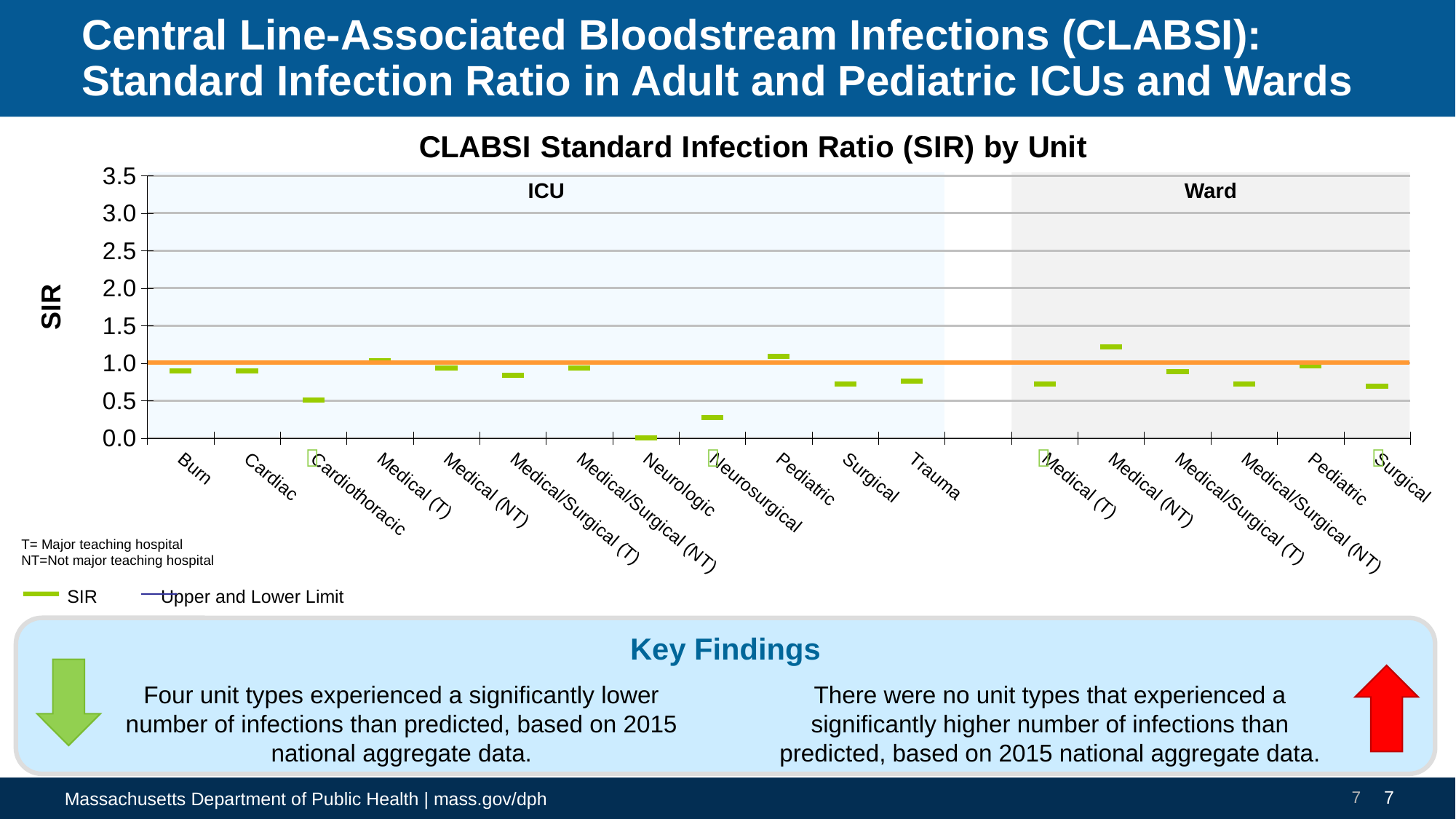
Is the SIR for the Medical (NT) Ward greater or less than 1.0? greater Is the SIR for the Pediatric ICU greater or less than 1.0? greater How many unit types are plotted in the Ward section of the chart? 6 How many unit types are plotted in the ICU section of the chart? 12 Which has a higher SIR, the Burn ICU or the Cardiothoracic ICU? Burn ICU Is the SIR for the Neurosurgical ICU greater or less than 0.5? less Which unit has the highest SIR on the chart? Medical (NT) Ward What is the title of the chart? CLABSI Standard Infection Ratio (SIR) by Unit Which unit has the lowest SIR on the chart? Neurologic (ICU) Which has a higher SIR, the Neurosurgical ICU or the Trauma ICU? Trauma ICU